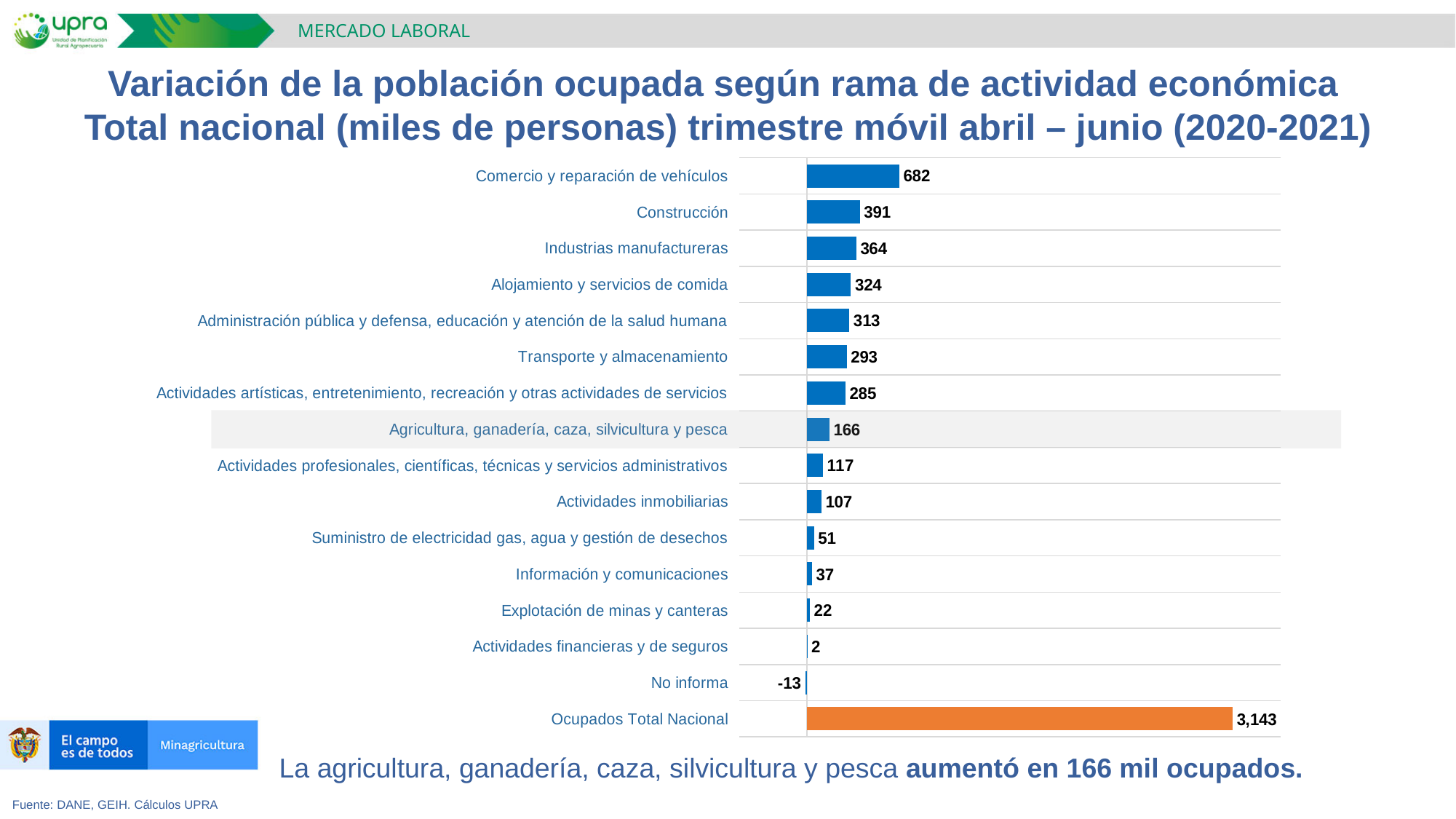
What is the value for No informa? -13 How many categories are shown in the chart? 16 What is the value for Agricultura, ganadería, caza, silvicultura y pesca? 166 Which is larger, the value for Transporte y almacenamiento or the value for Alojamiento y servicios de comida? Alojamiento y servicios de comida What is the difference between the values for Comercio y reparación de vehículos and Construcción? 291 What is the difference between the values for Industrias manufactureras and Actividades inmobiliarias? 257 Excluding Ocupados Total Nacional, which category has the highest value? Comercio y reparación de vehículos Which category has the lowest value? No informa What kind of chart is shown on the slide? Bar chart What is the value for Ocupados Total Nacional? 3,143 What is the value for Construcción? 391 Which bar is shown in orange rather than blue? Ocupados Total Nacional